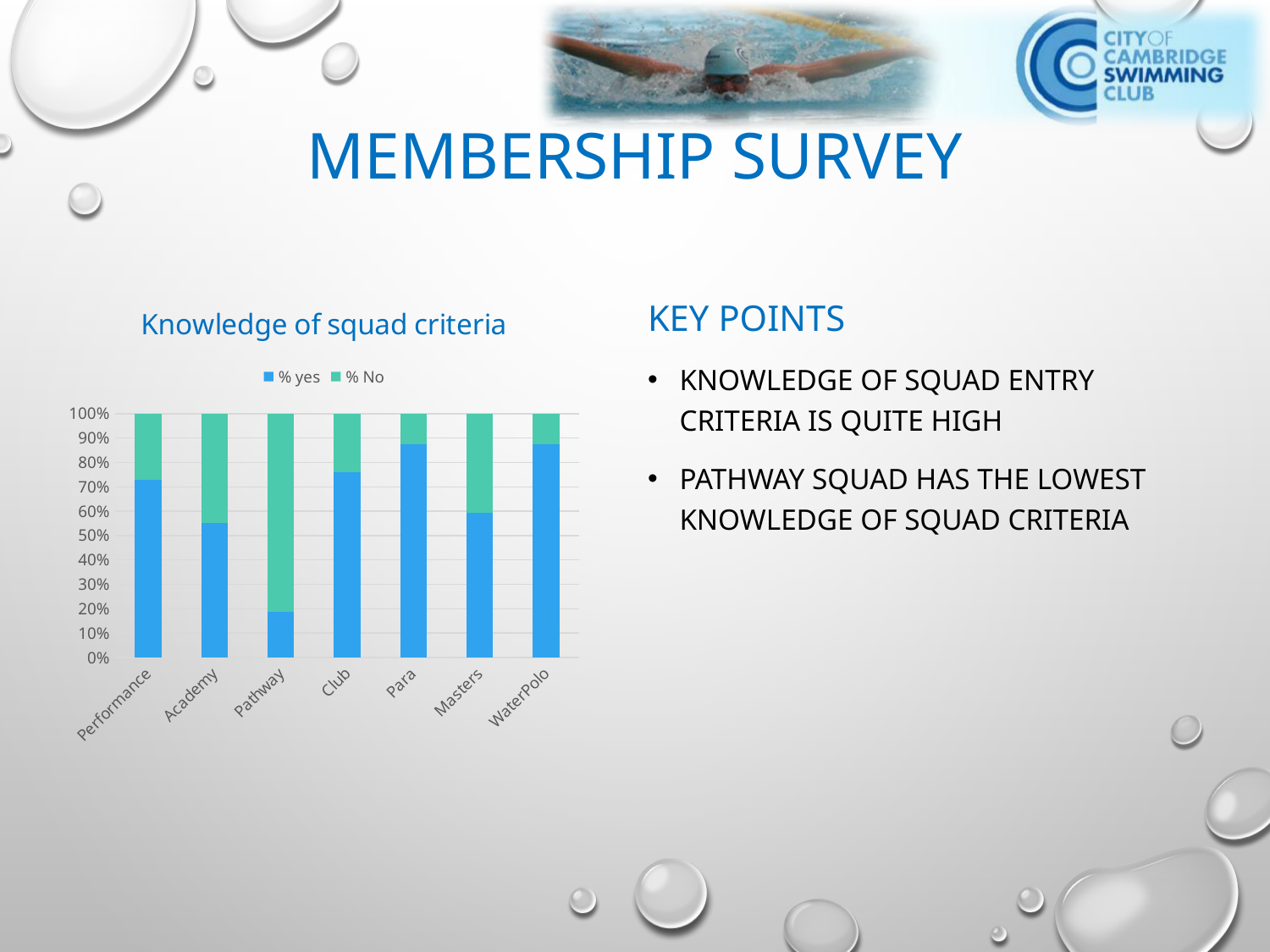
How many series does the chart legend list? 2 What is the title of the chart? Knowledge of squad criteria Which squad has a larger % yes value, Performance or Academy? Performance What type of chart is shown on the slide? Stacked bar chart Is the % yes value for Performance greater or less than 70%? greater Which squad has a larger % yes value, Club or Masters? Club How many squad categories are shown on the x axis of the chart? 7 What is the total of the stacked bar for Pathway (% yes plus % No)? 100% Which squad has the lowest % yes value in the chart? Pathway Is the % yes value for Academy greater or less than 60%? less Which squad has the highest % No value in the chart? Pathway